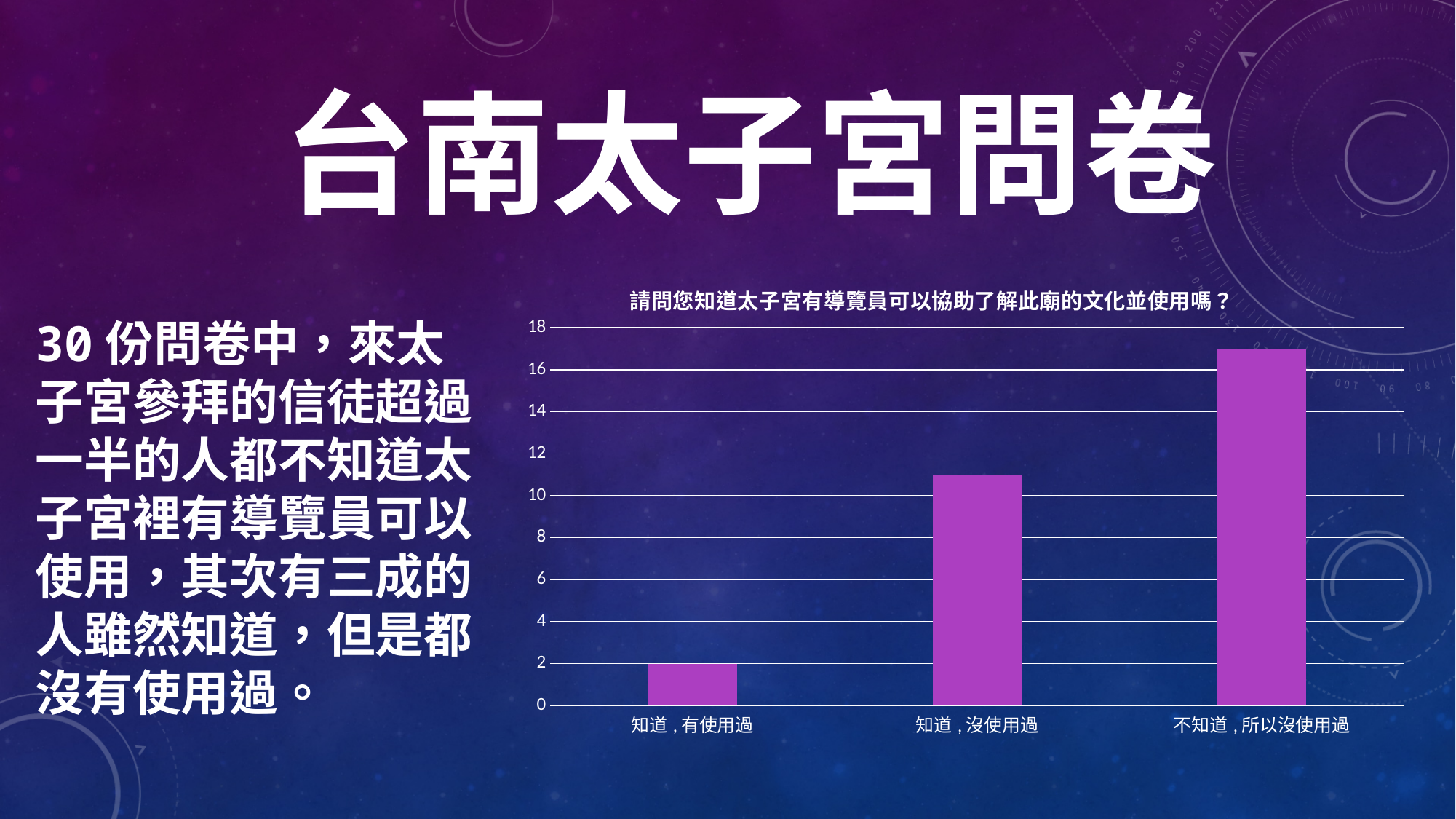
How many categories are shown on the x axis of the chart? 3 What is the title of the chart? 請問您知道太子宮有導覽員可以協助了解此廟的文化並使用嗎？ What is the value for 知道，有使用過 in the chart? 2 What is the highest value shown on the chart's vertical axis? 18 Which is larger: the value for 知道，沒使用過 or the value for 不知道，所以沒使用過? 不知道，所以沒使用過 Which category has the highest bar in the chart? 不知道，所以沒使用過 Is the value for 不知道，所以沒使用過 greater or less than 16? greater What kind of chart is shown on the slide? bar chart Which category has the lowest bar in the chart? 知道，有使用過 Is the value for 知道，沒使用過 greater or less than 10? greater Is the value for 知道，沒使用過 greater or less than 12? less Do the bar values rise or fall from left to right along the x axis? rise